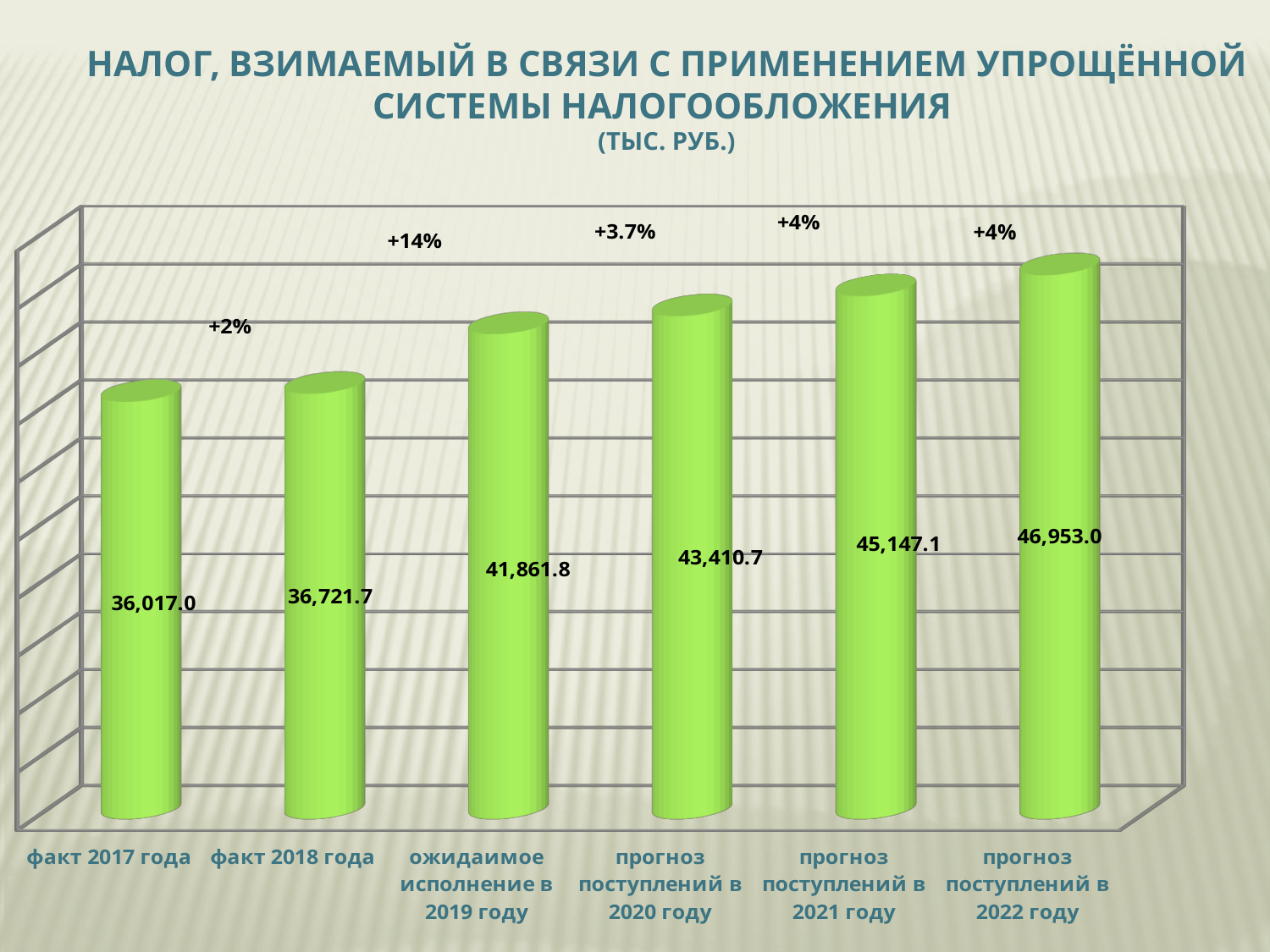
What percentage change is annotated above the bar for ожидаимое исполнение в 2019 году? +14% What kind of chart is shown on the slide? bar chart What is the difference between the values for прогноз поступлений в 2022 году and факт 2017 года? 10,936.0 What is the value for прогноз поступлений в 2020 году? 43,410.7 Which category has the highest value? прогноз поступлений в 2022 году What is the value for ожидаимое исполнение в 2019 году? 41,861.8 Which category has the lowest value? факт 2017 года Do the values rise or fall from факт 2017 года to прогноз поступлений в 2022 году? rise What is the difference between the values for ожидаимое исполнение в 2019 году and факт 2018 года? 5,140.1 How many categories are shown in the chart? 6 What is the value for факт 2017 года? 36,017.0 Which is larger, the value for прогноз поступлений в 2021 году or the value for прогноз поступлений в 2020 году? прогноз поступлений в 2021 году